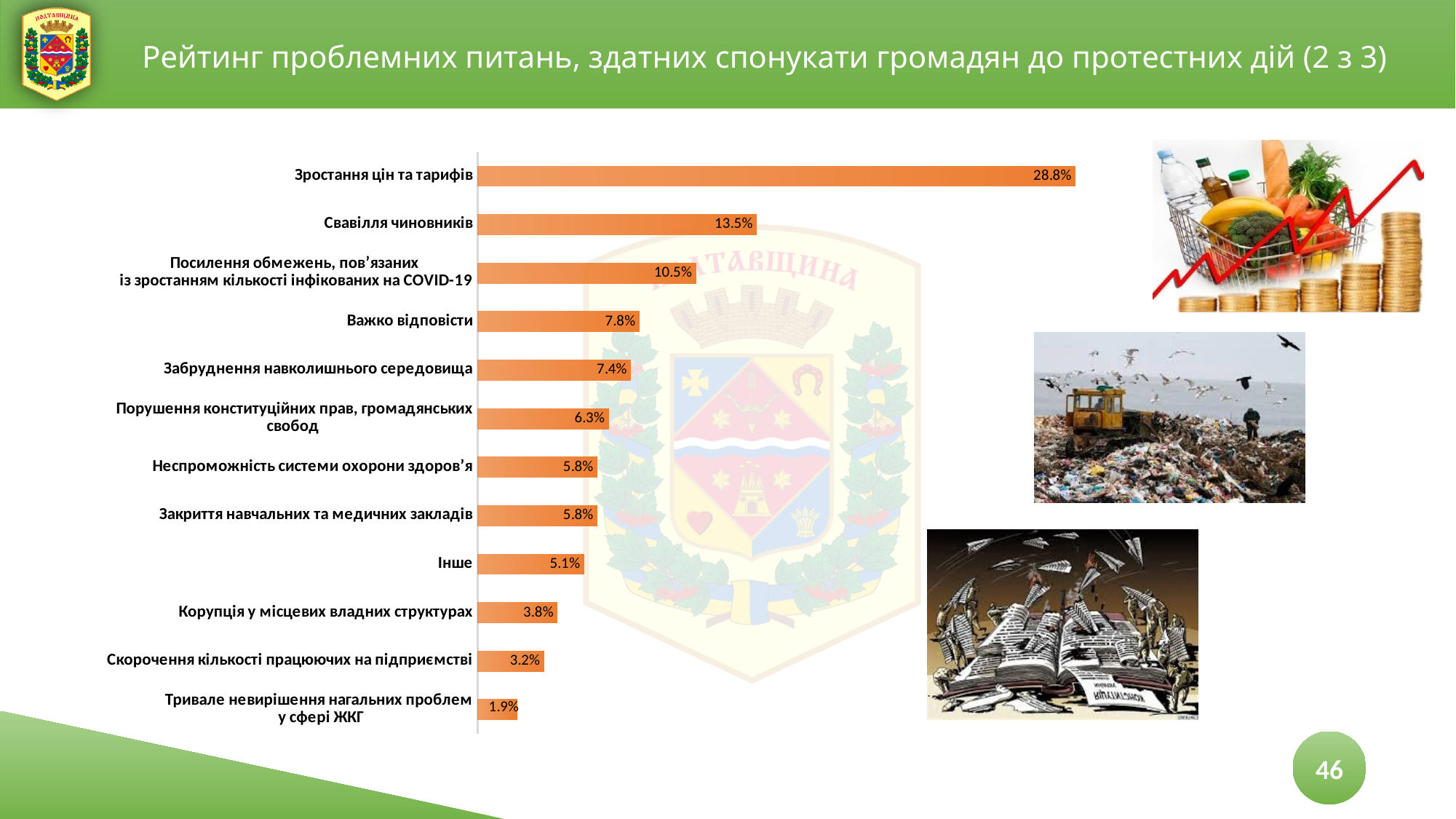
Which category has the highest value? Зростання цін та тарифів What value is shown for "Забруднення навколишнього середовища"? 7.4% What value is shown for "Корупція у місцевих владних структурах"? 3.8% What value is shown for "Свавілля чиновників"? 13.5% How many categories are shown in the chart? 12 What kind of chart is shown on the slide? Bar chart What colour are the bars in the chart? Orange Which category has the lowest value? Тривале невирішення нагальних проблем у сфері ЖКГ What is the difference between the values for "Зростання цін та тарифів" and "Свавілля чиновників"? 15.3% Which is larger: the value for "Важко відповісти" or the value for "Інше"? Важко відповісти What value is shown for "Зростання цін та тарифів"? 28.8% Do the values rise or fall going from the top bar to the bottom bar? Fall